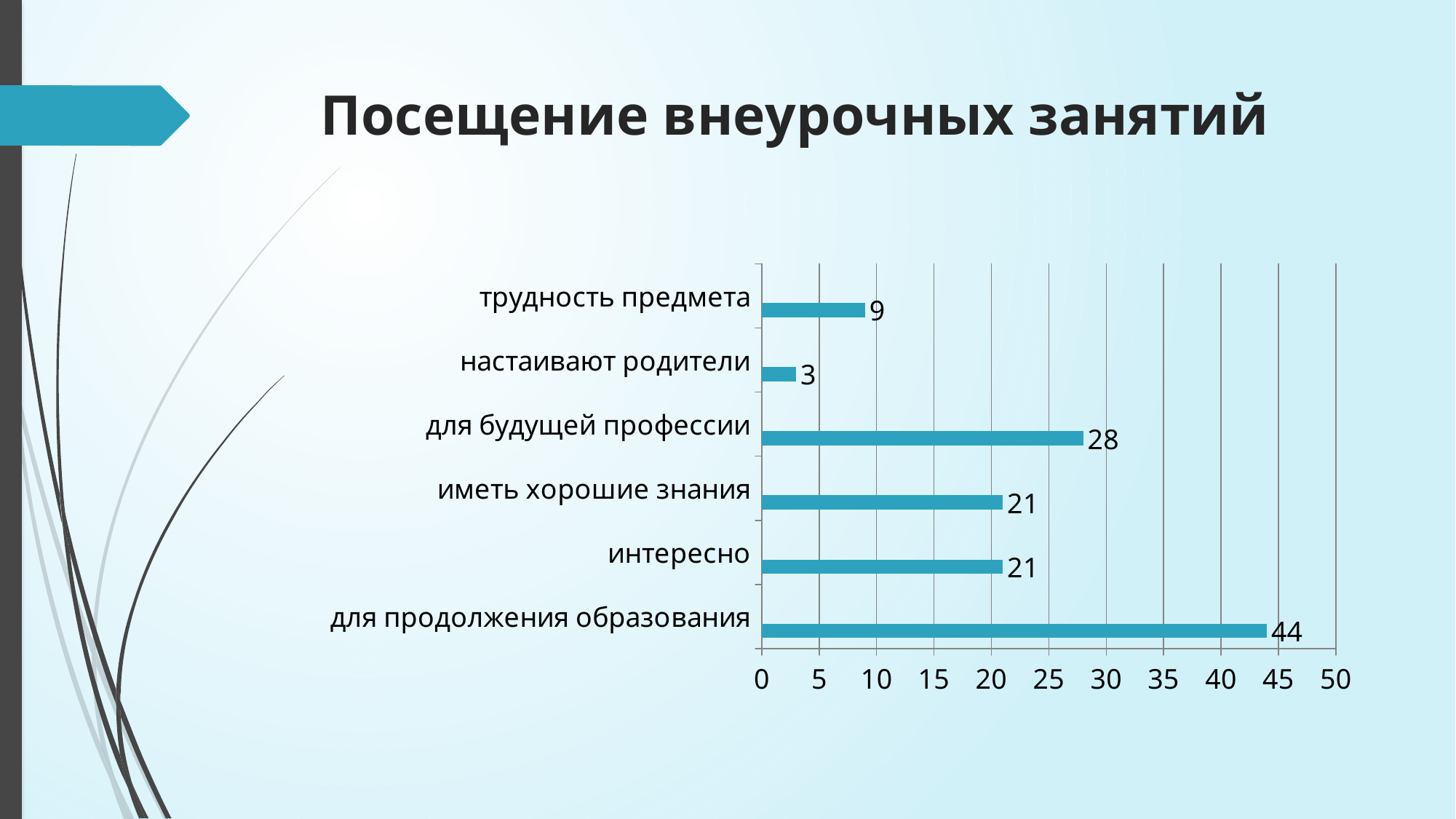
Which is larger, the value for "для будущей профессии" or the value for "иметь хорошие знания"? для будущей профессии What is the difference between the values for "для продолжения образования" and "для будущей профессии"? 16 What kind of chart is shown on the slide? bar chart Which category has the lowest value? настаивают родители What is the value for "настаивают родители"? 3 What is the value for "трудность предмета"? 9 Which category has the highest value? для продолжения образования What is the difference between the values for "трудность предмета" and "настаивают родители"? 6 What is the value for "для будущей профессии"? 28 What is the title of the slide? Посещение внеурочных занятий How many categories are shown in the chart? 6 What is the value for "для продолжения образования"? 44